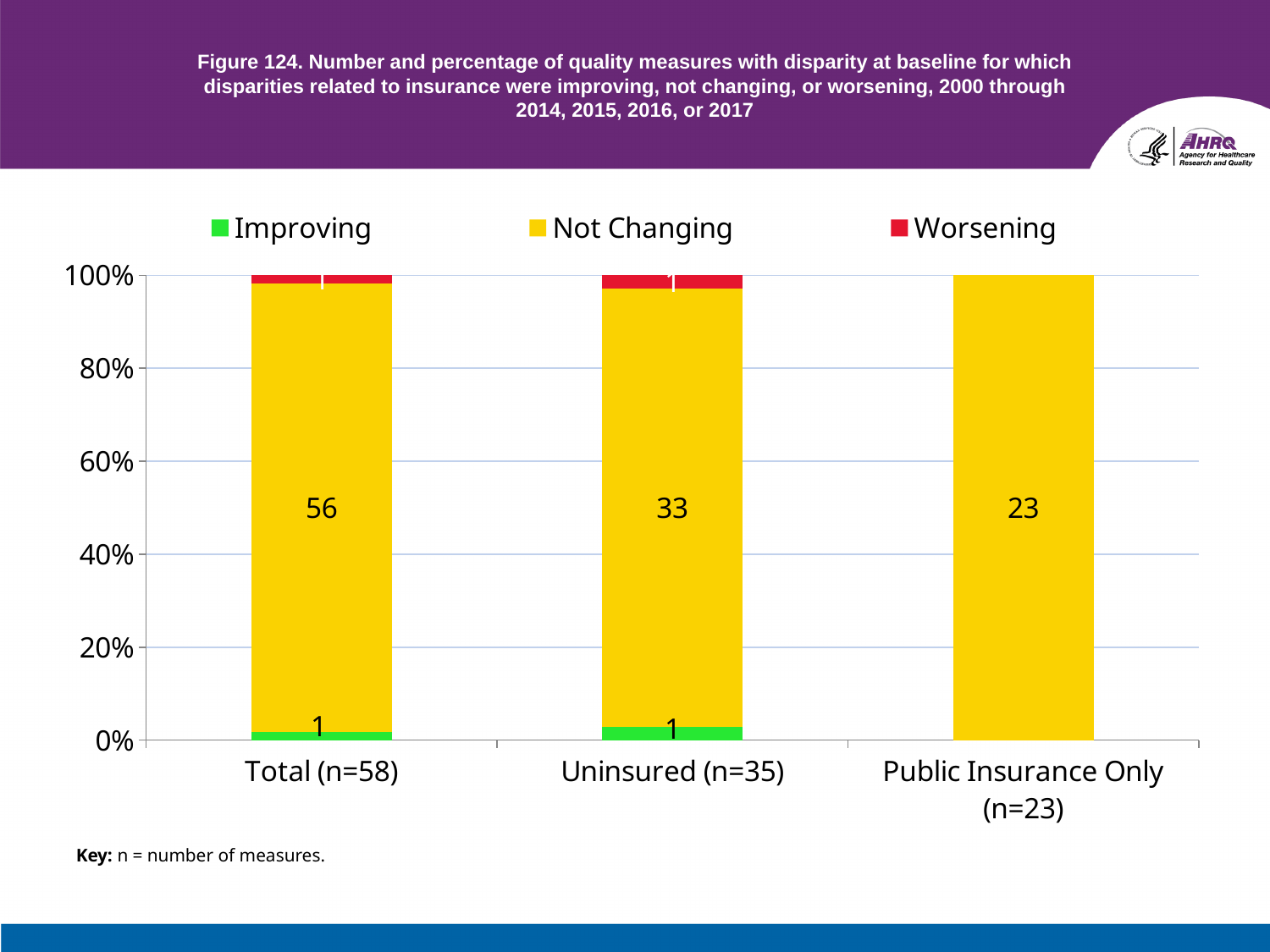
What is the value for Not Changing in the Uninsured (n=35) bar? 33 What is the value for Improving in the Uninsured (n=35) bar? 1 Is the Not Changing share of the Public Insurance Only (n=23) bar greater or less than 80%? greater What is the value for Improving in the Total (n=58) bar? 1 What is the difference between the Not Changing values for Total (n=58) and Uninsured (n=35)? 23 How many categories are shown on the x axis? 3 What is the value for Not Changing in the Public Insurance Only (n=23) bar? 23 What kind of chart is shown on the slide? Stacked bar chart How many series does the legend list? 3 Which category has the highest Not Changing value? Total (n=58) Which category has the lowest Not Changing value? Public Insurance Only (n=23) What is the value for Not Changing in the Total (n=58) bar? 56